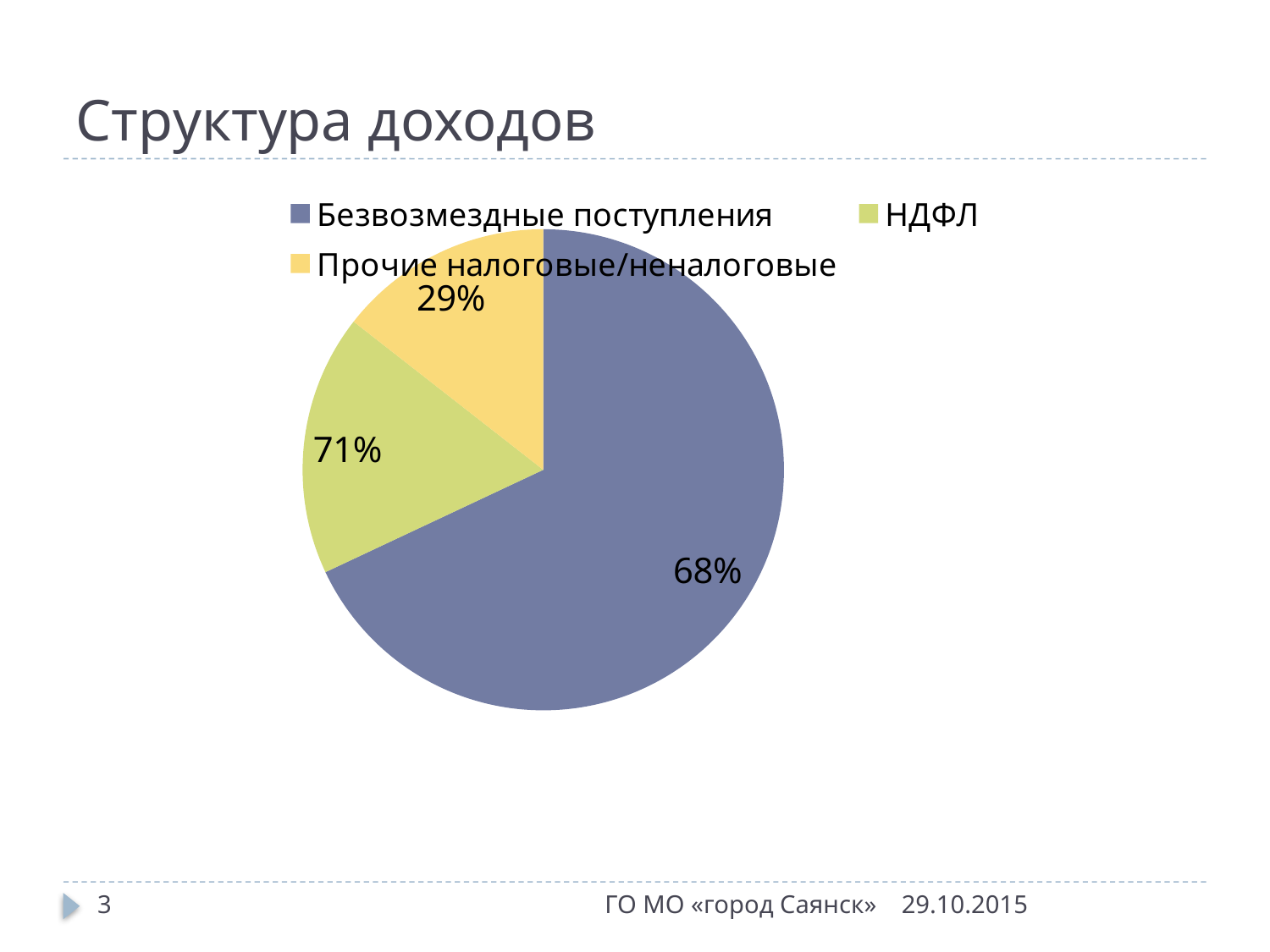
What is the difference between the labelled values for Безвозмездные поступления and Прочие налоговые/неналоговые? 39% How many slices does the pie chart have? 3 What colour is the slice for НДФЛ? green Which slice is larger: НДФЛ or Прочие налоговые/неналоговые? НДФЛ What value is labelled on the slice for Прочие налоговые/неналоговые? 29% How many entries does the legend list? 3 What value is labelled on the slice for Безвозмездные поступления? 68% What value is labelled on the slice for НДФЛ? 71% What is the title of the chart on the slide? Структура доходов What kind of chart is shown on the slide? pie chart Which slice is larger: Безвозмездные поступления or Прочие налоговые/неналоговые? Безвозмездные поступления